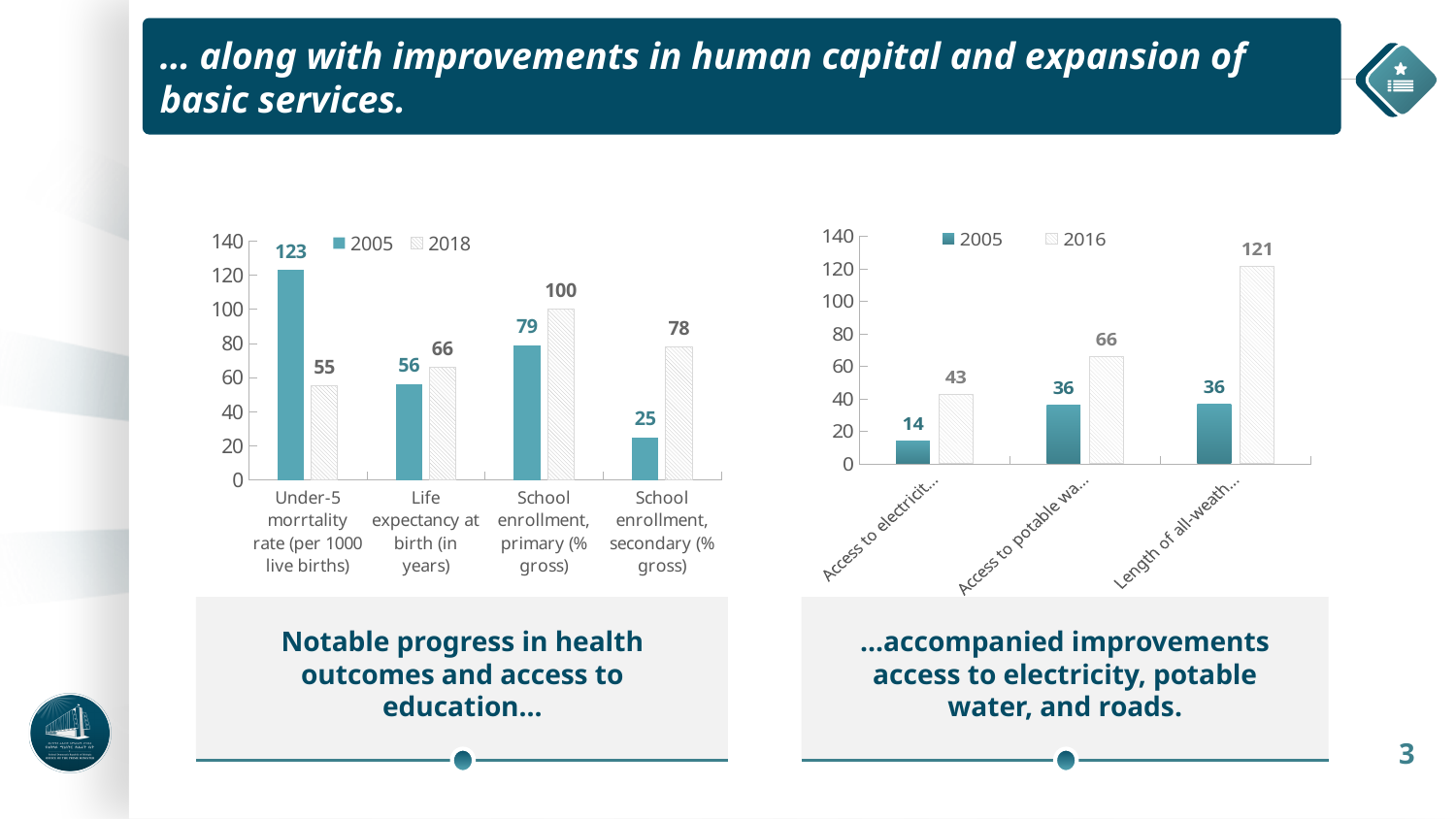
In the left chart, which category has the highest 2018 value? School enrollment, primary (% gross) In the left chart, what is the 2018 value for Life expectancy at birth (in years)? 66 In the left chart, what is the 2005 value for Under-5 mortality rate (per 1000 live births)? 123 What type of chart is the right chart? Bar chart In the right chart, what is the 2005 value for the category labelled 'Access to electricit...'? 14 In the left chart, what is the difference between the 2005 and 2018 values for Under-5 mortality rate? 68 In the left chart, what is the 2018 value for School enrollment, secondary (% gross)? 78 In the right chart, which series does the legend list besides 2005? 2016 In the left chart, how many categories are shown on the x axis? 4 In the right chart, what is the 2016 value for the category labelled 'Length of all-weath...'? 121 In the right chart, what is the difference between the 2016 and 2005 values for the category labelled 'Access to potable wa...'? 30 In the left chart, which category has the lowest 2005 value? School enrollment, secondary (% gross)